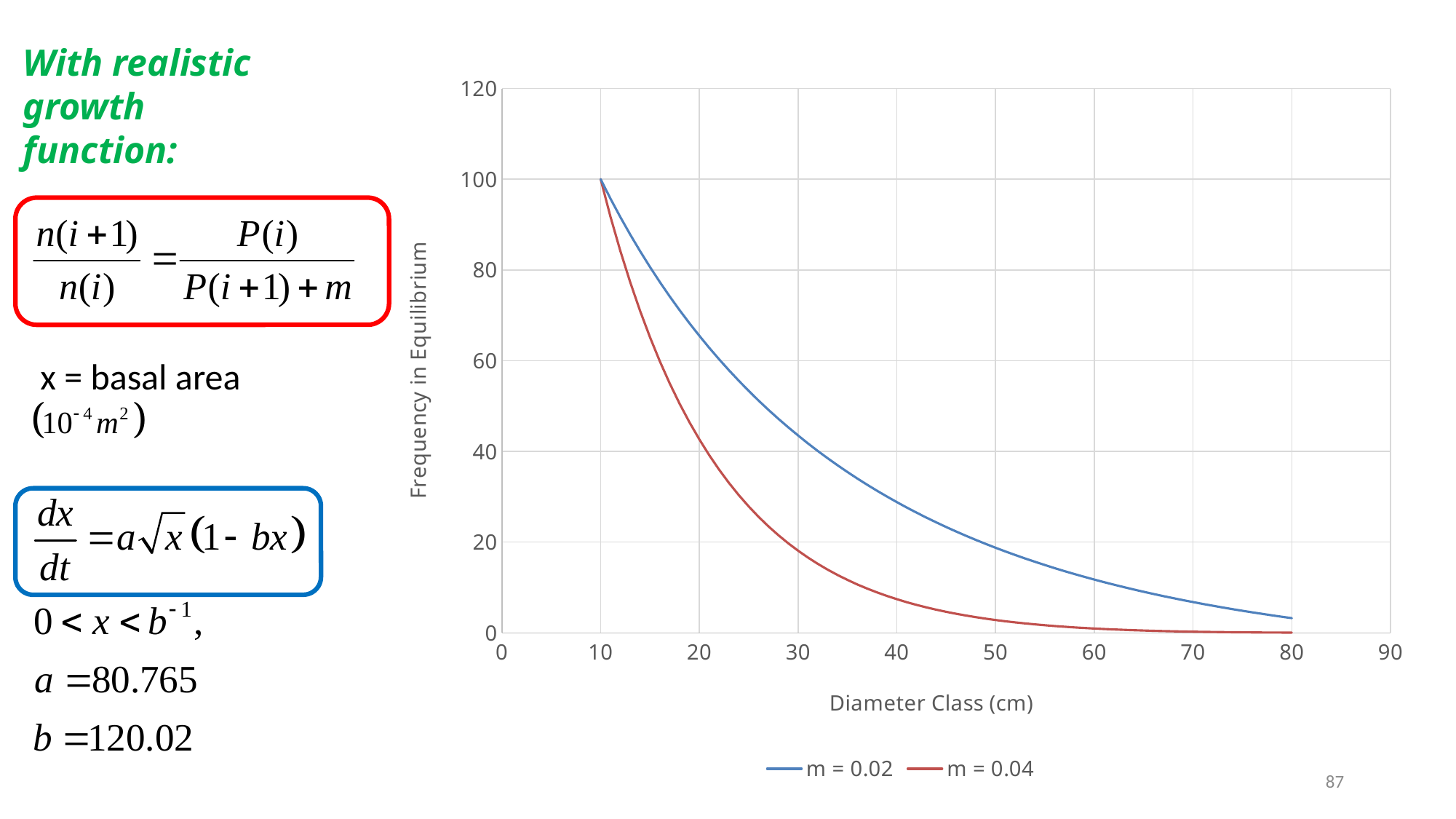
Is the Frequency in Equilibrium for the m = 0.02 series at a Diameter Class of 20 cm greater or less than 60? greater Is the Frequency in Equilibrium for the m = 0.02 series at a Diameter Class of 30 cm greater or less than 40? greater Do the values of the m = 0.02 series rise or fall as Diameter Class increases? fall What are the two series named in the chart's legend? m = 0.02 and m = 0.04 How many series does the chart's legend list? 2 What kind of chart is shown on the slide? line chart Which series stays higher across the Diameter Class range above 10 cm, m = 0.02 or m = 0.04? m = 0.02 Is the Frequency in Equilibrium for the m = 0.04 series at a Diameter Class of 40 cm greater or less than 20? less What is the Frequency in Equilibrium for the m = 0.04 series at a Diameter Class of 10 cm? 100 At a Diameter Class of 30 cm, which series has the higher Frequency in Equilibrium, m = 0.02 or m = 0.04? m = 0.02 What is the title of the chart's vertical axis? Frequency in Equilibrium